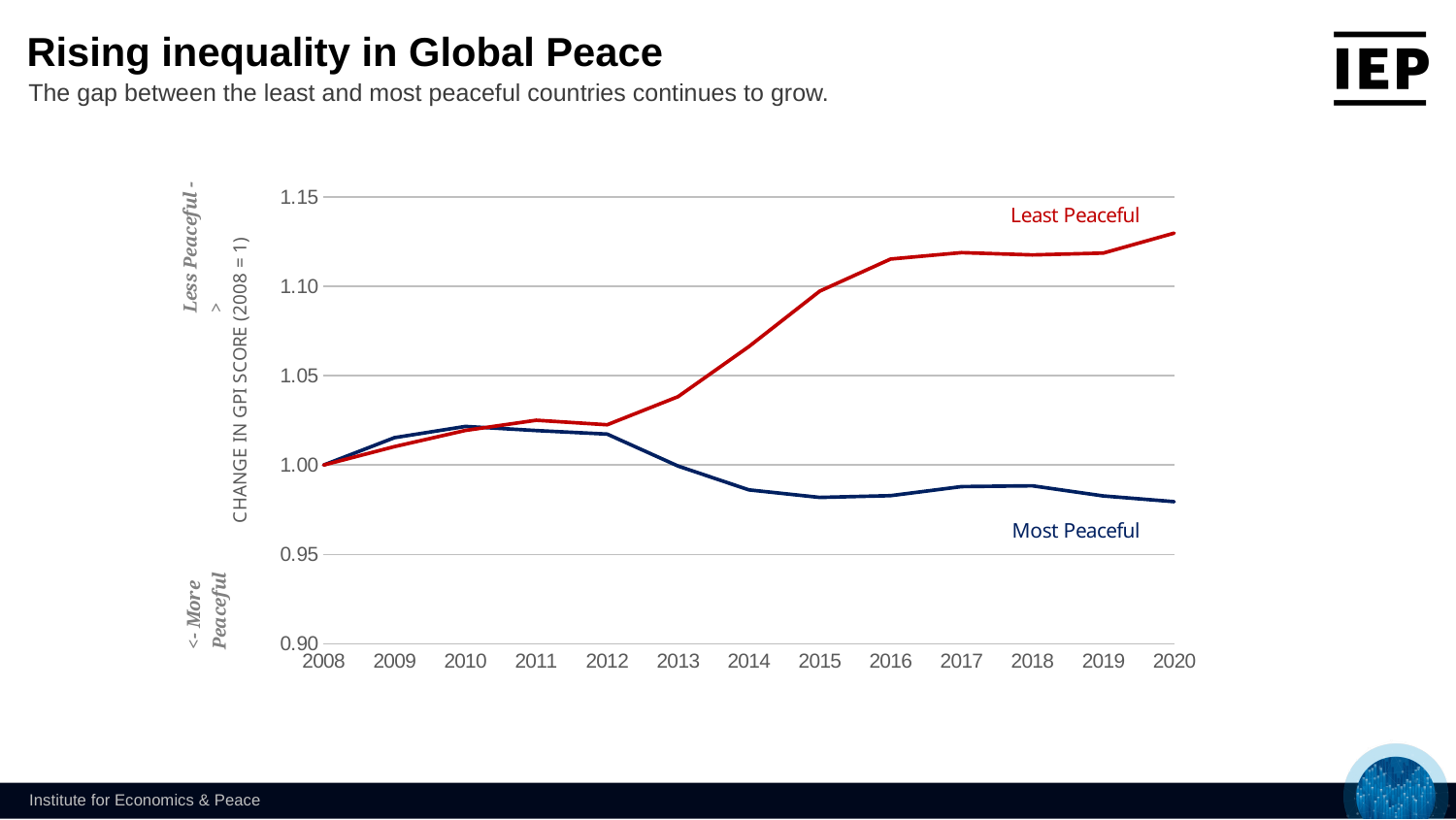
Which series has the higher value in 2020, Least Peaceful or Most Peaceful? Least Peaceful What is the value of the Most Peaceful series in 2008? 1.00 Does the Least Peaceful series generally rise or fall from 2008 to 2020? rise How many years are shown along the x axis of the chart? 13 Is the value for Least Peaceful in 2013 greater or less than 1.05? less What kind of chart is shown on the slide? line chart How many series are plotted on the chart? 2 Is the value for Least Peaceful in 2020 greater or less than 1.10? greater What is the label on the y axis of the chart? CHANGE IN GPI SCORE (2008 = 1) What is the value of the Least Peaceful series in 2008? 1.00 In which year does the Least Peaceful series reach its highest value? 2020 Is the value for Most Peaceful in 2020 greater or less than 1.00? less